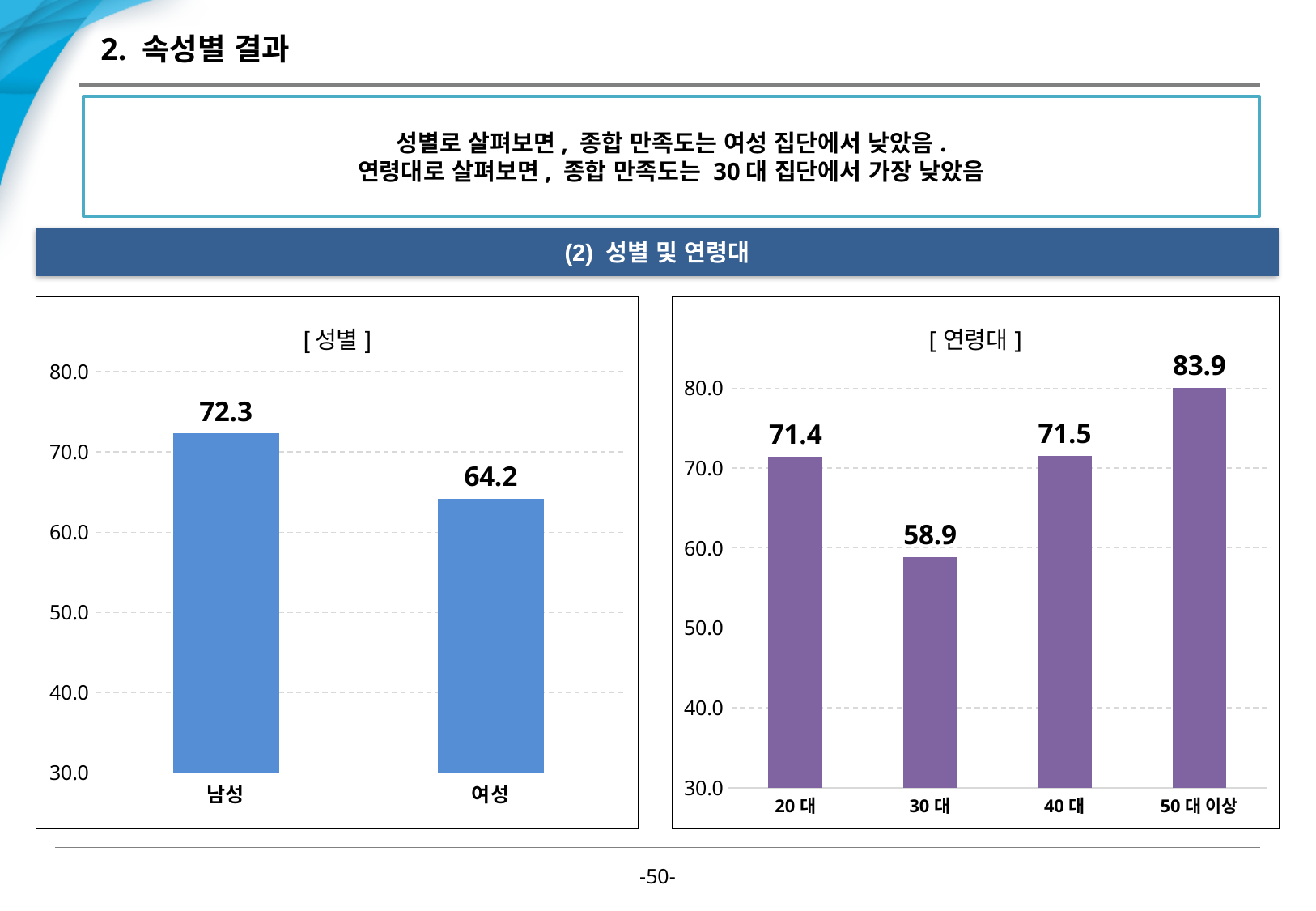
In the [성별] chart on the left, what is the difference between the values for 남성 and 여성? 8.1 In the [연령대] chart on the right, how many categories are shown? 4 In the [연령대] chart on the right, which category has the lowest value? 30 대 In the [성별] chart on the left, which category has the higher value, 남성 or 여성? 남성 In the [연령대] chart on the right, which category has the highest value? 50 대 이상 In the [연령대] chart on the right, is the value for 30 대 greater or less than 60.0? less In the [연령대] chart on the right, what is the value for 30 대? 58.9 In the [연령대] chart on the right, what is the difference between the values for 50 대 이상 and 30 대? 25.0 In the [성별] chart on the left, what is the value for 남성? 72.3 What kind of chart is the [성별] chart on the left? bar chart In the [성별] chart on the left, what is the value for 여성? 64.2 In the [연령대] chart on the right, what is the value for 50 대 이상? 83.9